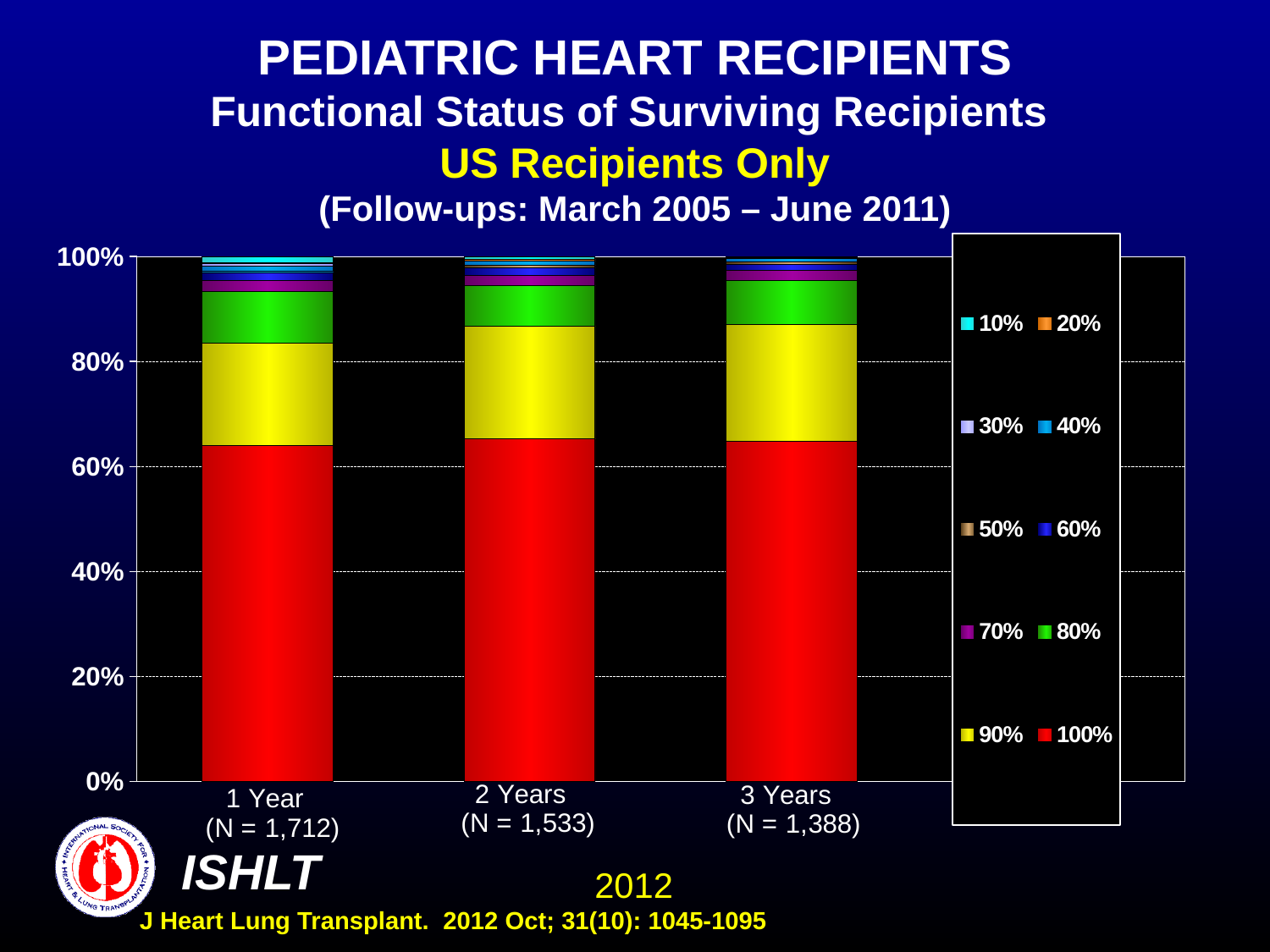
What is the N shown for the 2 Years category? 1,533 What follow-up period is stated in the chart title? March 2005 – June 2011 What is the N shown for the 1 Year category? 1,712 What kind of chart is shown on the slide? Stacked bar chart How many series does the legend list? 10 Is the 100% functional status segment for 1 Year greater or less than 60%? greater What is the N shown for the 3 Years category? 1,388 Does the top of the 90% segment for 2 Years reach greater or less than 80%? greater Is the 100% functional status segment for 3 Years greater or less than 80%? less What is the total height of the stacked bar for 1 Year? 100% How many categories are shown on the x axis of the chart? 3 Which colour represents the 100% functional status series in the legend? Red